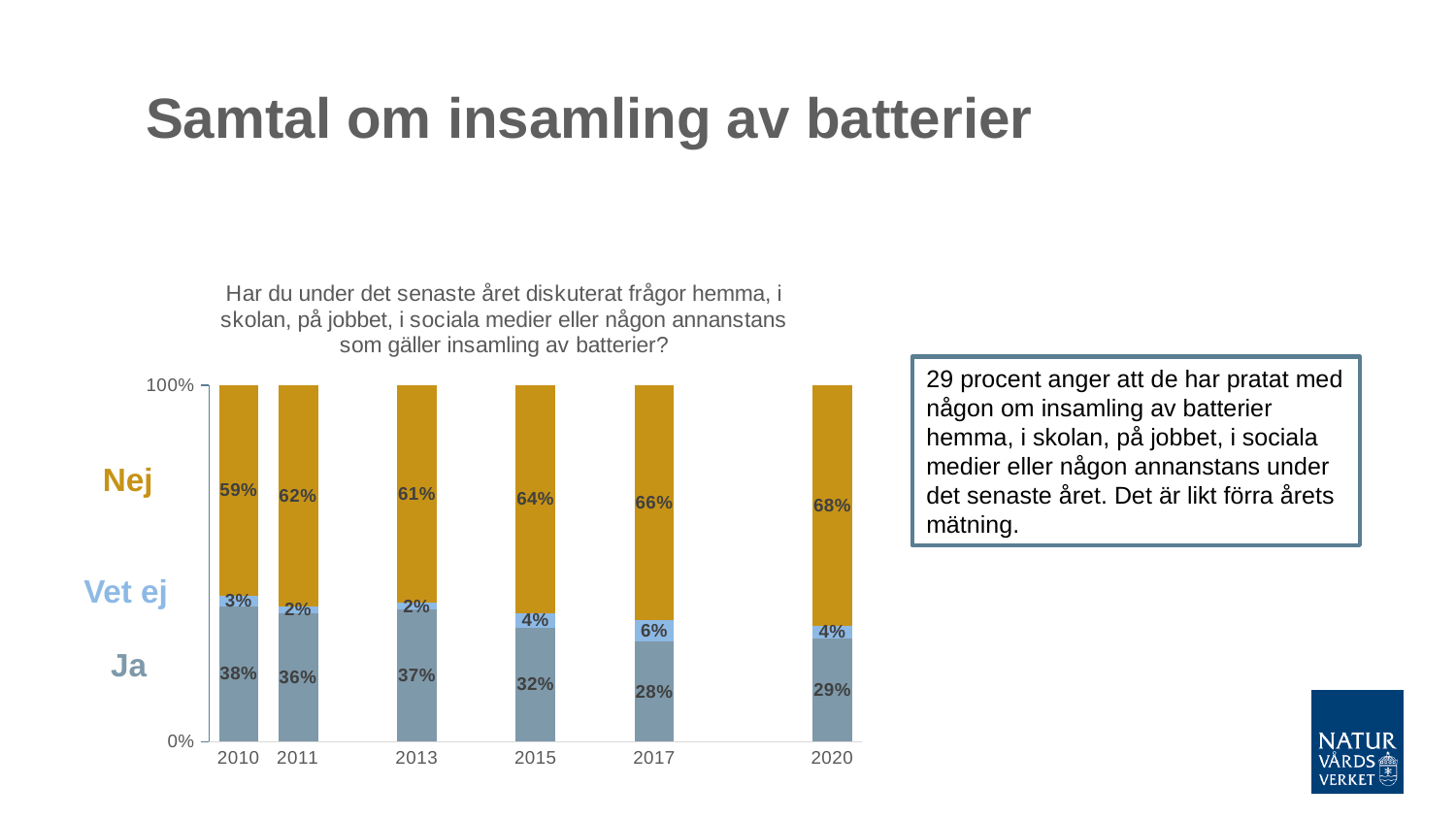
In which year was the "Nej" share lowest? 2010 How many years are shown on the x axis? 6 What percentage answered "Nej" in 2010? 59% In which year was the "Ja" share highest? 2010 What is the total of the 2015 bar (Ja + Vet ej + Nej)? 100% What is the difference between the "Nej" share in 2020 and in 2010? 9 percentage points What kind of chart is shown on the slide? Stacked bar chart What percentage answered "Vet ej" in 2017? 6% What percentage answered "Ja" in 2020? 29% How many response categories (series) are shown in the stacked bars? 3 Which is larger: the "Ja" share in 2013 or in 2015? 2013 Does the "Nej" share generally rise or fall from 2010 to 2020? Rise